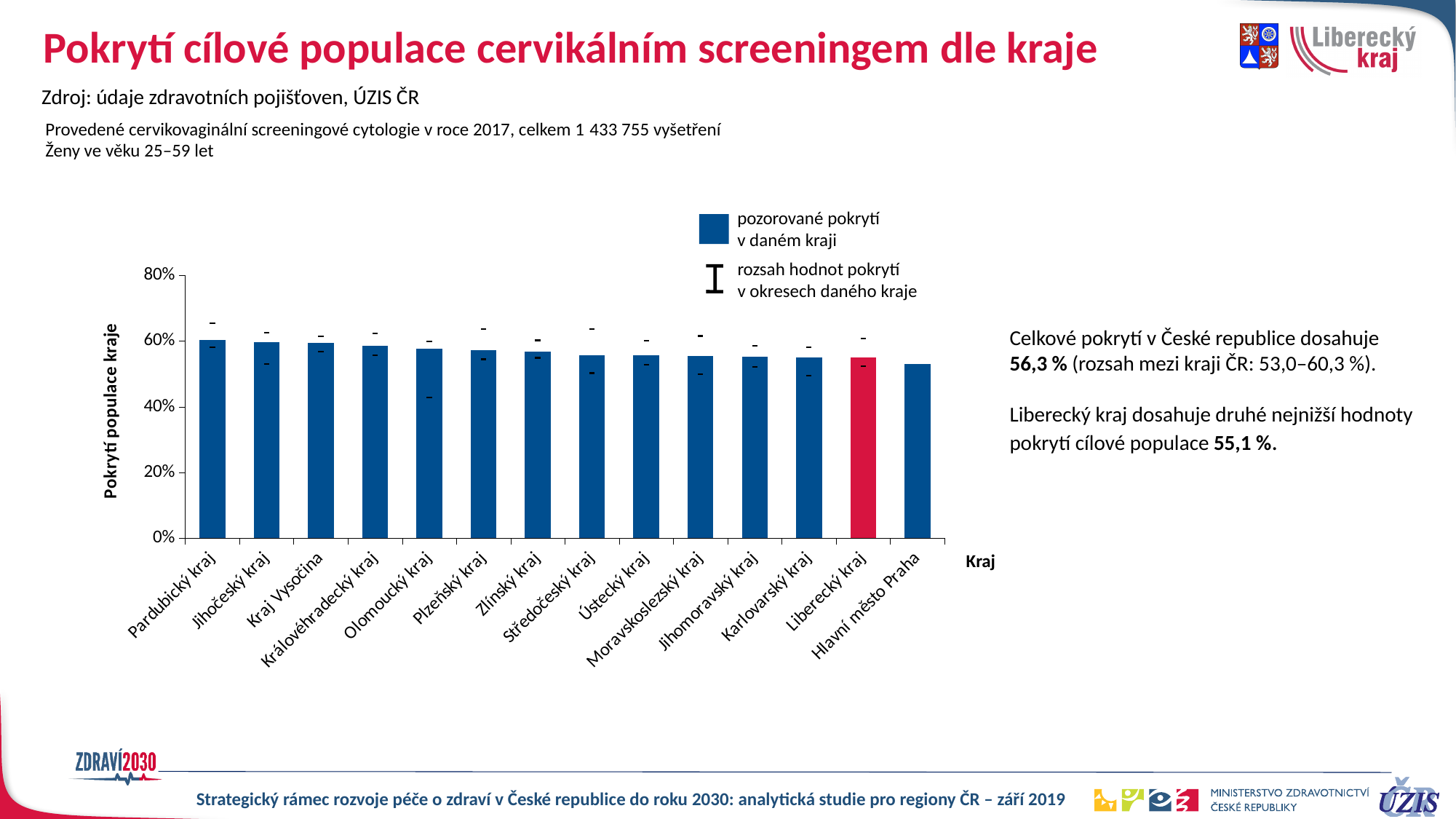
Is the coverage for Hlavní město Praha greater or less than 60%? less What is the coverage value for Liberecký kraj? 55,1 % Which region's bar is highlighted in red? Liberecký kraj What kind of chart is shown on the slide? bar chart How many regions (kraje) are shown on the x axis of the chart? 14 How many entries does the chart legend list? 2 Which region has the lowest coverage in the chart? Hlavní město Praha Which region has the highest coverage in the chart? Pardubický kraj Which has higher coverage, Pardubický kraj or Hlavní město Praha? Pardubický kraj Is the coverage for Olomoucký kraj greater or less than 40%? greater Which has higher coverage, Jihočeský kraj or Liberecký kraj? Jihočeský kraj Do the bar values rise or fall from left to right along the x axis? fall